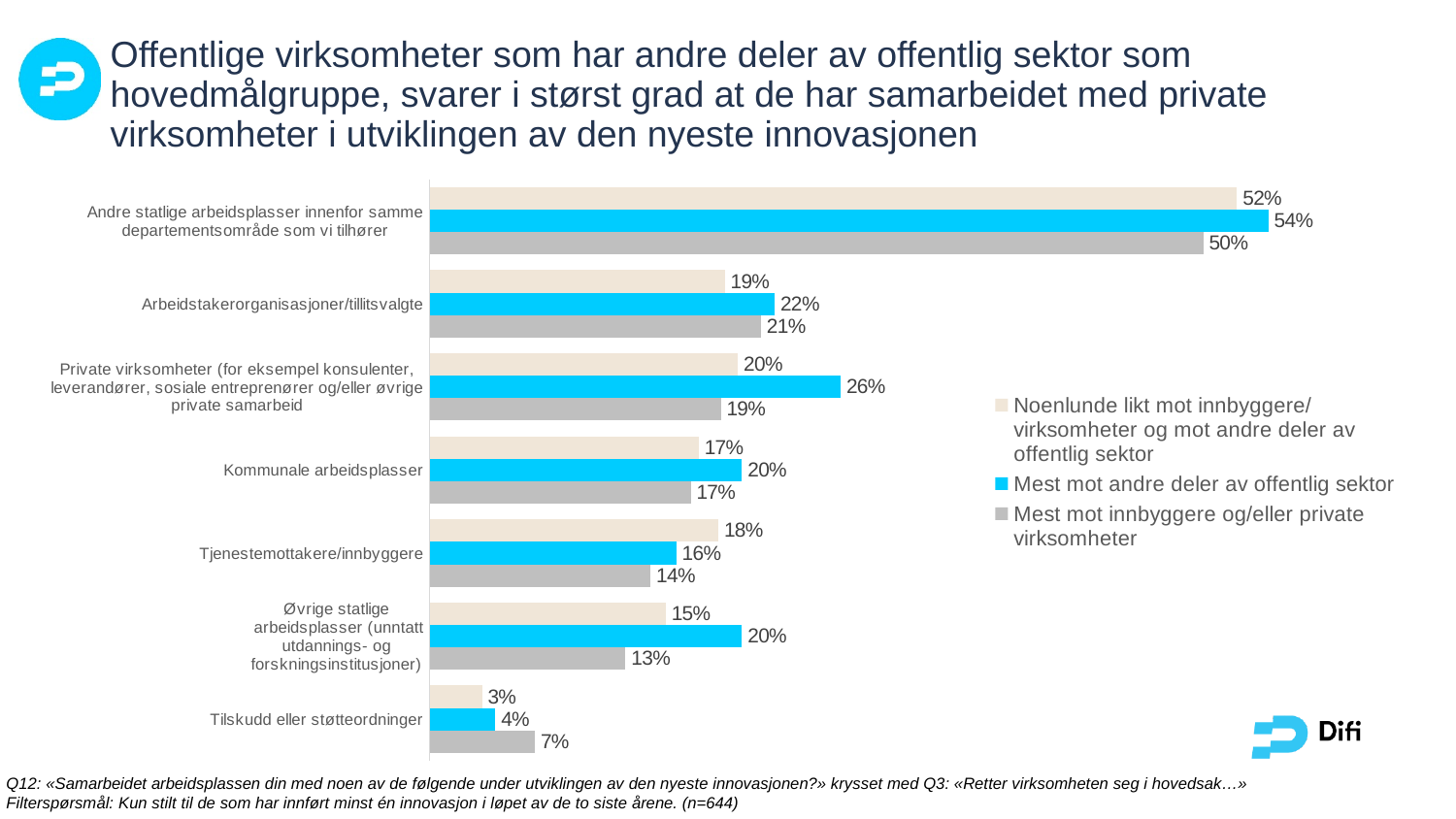
What is the value for 'Mest mot andre deler av offentlig sektor' in the category 'Andre statlige arbeidsplasser innenfor samme departementsområde som vi tilhører'? 54% What is the value for 'Mest mot innbyggere og/eller private virksomheter' in the category 'Tilskudd eller støtteordninger'? 7% What is the value for 'Mest mot andre deler av offentlig sektor' in the category 'Private virksomheter (for eksempel konsulenter, leverandører, sosiale entreprenører og/eller øvrige private samarbeid)'? 26% How many categories are shown on the chart? 7 What kind of chart is shown on the slide? bar chart What is the difference between the 'Mest mot andre deler av offentlig sektor' value and the 'Mest mot innbyggere og/eller private virksomheter' value for 'Øvrige statlige arbeidsplasser (unntatt utdannings- og forskningsinstitusjoner)'? 7% Which category has the highest value for 'Mest mot andre deler av offentlig sektor'? Andre statlige arbeidsplasser innenfor samme departementsområde som vi tilhører Which colour represents the series 'Mest mot andre deler av offentlig sektor'? blue For 'Tjenestemottakere/innbyggere', which series has the larger value: 'Noenlunde likt mot innbyggere/virksomheter og mot andre deler av offentlig sektor' or 'Mest mot innbyggere og/eller private virksomheter'? Noenlunde likt mot innbyggere/virksomheter og mot andre deler av offentlig sektor What is the value for 'Noenlunde likt mot innbyggere/virksomheter og mot andre deler av offentlig sektor' in the category 'Kommunale arbeidsplasser'? 17% Which category has the lowest value for 'Noenlunde likt mot innbyggere/virksomheter og mot andre deler av offentlig sektor'? Tilskudd eller støtteordninger How many series does the legend list? 3